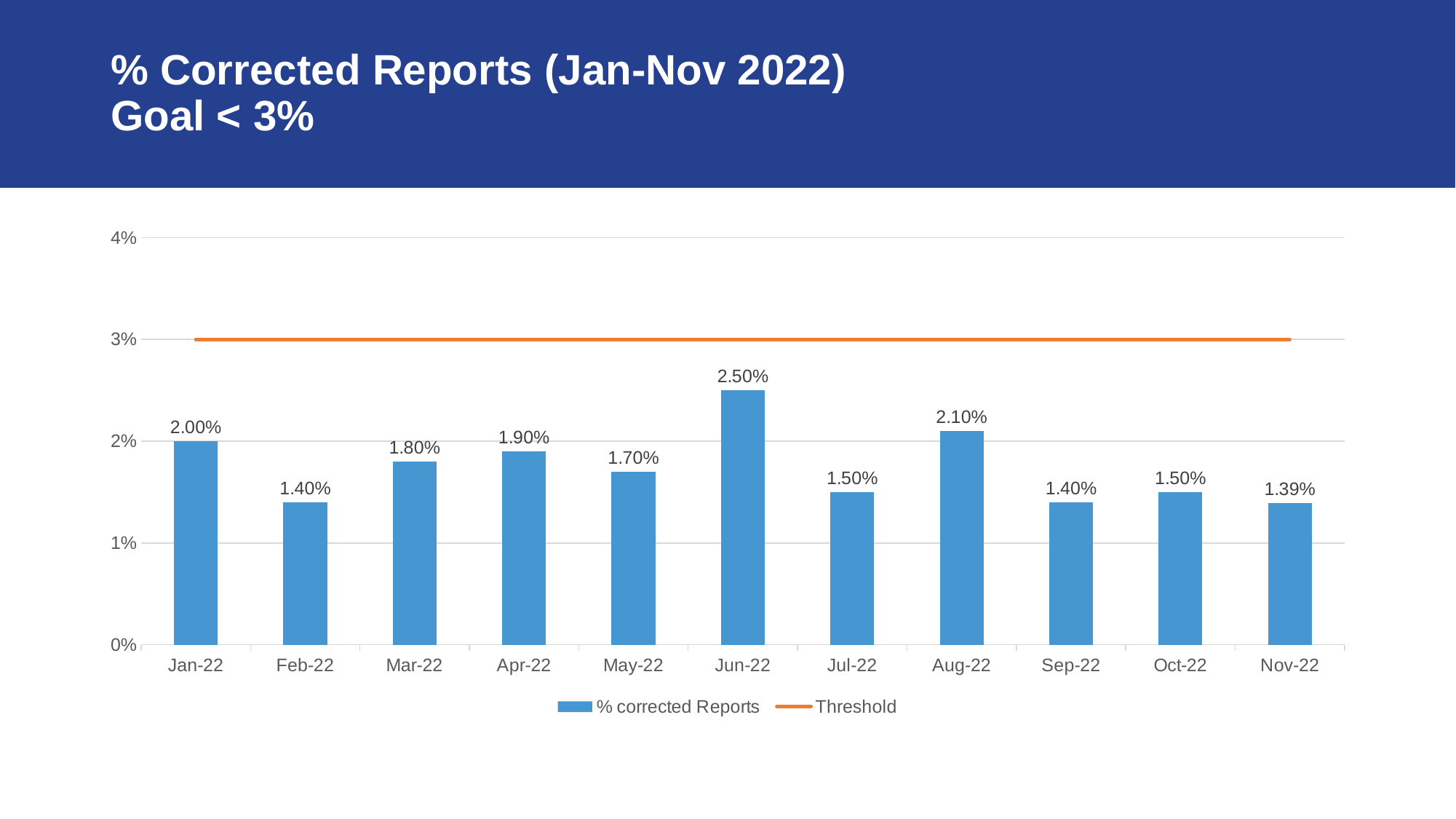
What colour is the Threshold line? orange Which is larger, the % corrected Reports for Mar-22 or May-22? Mar-22 How many months are shown on the x axis? 11 What is the % corrected Reports value for Jun-22? 2.50% What is the difference between the % corrected Reports for Jun-22 and Aug-22? 0.40% Which month has the lowest % corrected Reports? Nov-22 Is the Threshold line greater or less than 2%? greater What is the % corrected Reports value for Nov-22? 1.39% What kind of chart is used to show the % corrected Reports? bar chart Which month has the highest % corrected Reports? Jun-22 What is the % corrected Reports value for Jan-22? 2.00% How many series does the legend list? 2